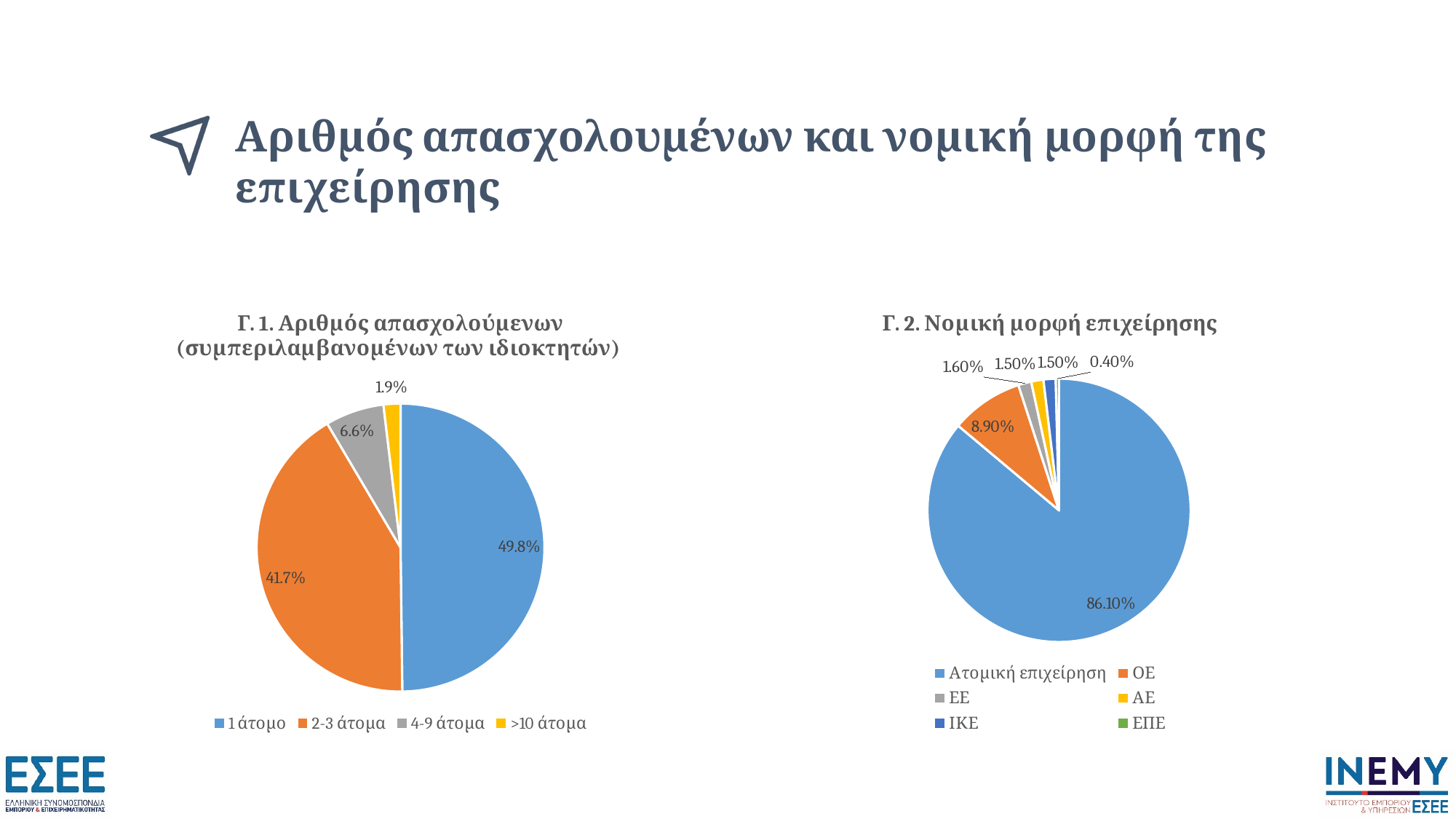
In the chart 'Γ. 2. Νομική μορφή επιχείρησης', what share is shown for 'ΟΕ'? 8.90% In the chart 'Γ. 2. Νομική μορφή επιχείρησης', which category has the smallest slice? ΕΠΕ What type of chart is 'Γ. 2. Νομική μορφή επιχείρησης'? Pie chart In the chart 'Γ. 1. Αριθμός απασχολούμενων', what share is shown for '2-3 άτομα'? 41.7% In the chart 'Γ. 2. Νομική μορφή επιχείρησης', how many categories does the legend list? 6 In the chart 'Γ. 1. Αριθμός απασχολούμενων', which category has the smallest slice? >10 άτομα In the chart 'Γ. 2. Νομική μορφή επιχείρησης', which category has the largest slice? Ατομική επιχείρηση In the chart 'Γ. 1. Αριθμός απασχολούμενων', what is the difference between the shares for '1 άτομο' and '2-3 άτομα'? 8.1% In the chart 'Γ. 2. Νομική μορφή επιχείρησης', what share is shown for 'Ατομική επιχείρηση'? 86.10% In the chart 'Γ. 1. Αριθμός απασχολούμενων', what share is shown for '1 άτομο'? 49.8% In the chart 'Γ. 1. Αριθμός απασχολούμενων', which is larger: the share for '4-9 άτομα' or for '>10 άτομα'? 4-9 άτομα In the chart 'Γ. 1. Αριθμός απασχολούμενων', how many categories does the legend list? 4